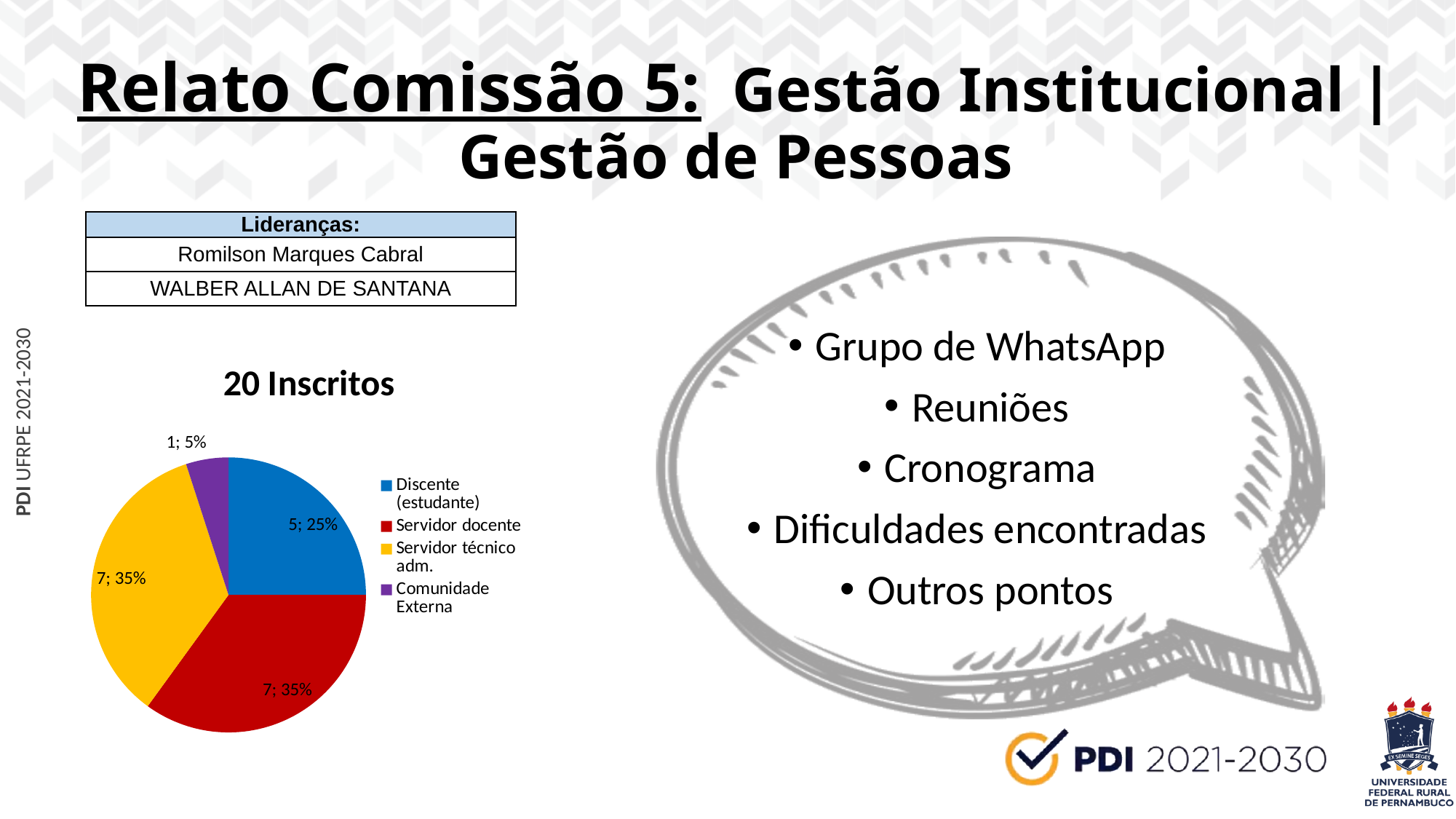
What type of chart is shown on the slide? Pie chart What is the value for Comunidade Externa? 1 What is the value for Discente (estudante)? 5 Which is larger, the value for Discente (estudante) or the value for Comunidade Externa? Discente (estudante) How many categories does the pie chart have? 4 What share of the pie does Discente (estudante) represent? 25% How many entries does the chart legend list? 4 What is the difference between the values for Servidor docente and Discente (estudante)? 2 What share of the pie does Servidor técnico adm. represent? 35% Which category has the smallest slice? Comunidade Externa What is the title of the chart? 20 Inscritos What is the value for Servidor docente? 7